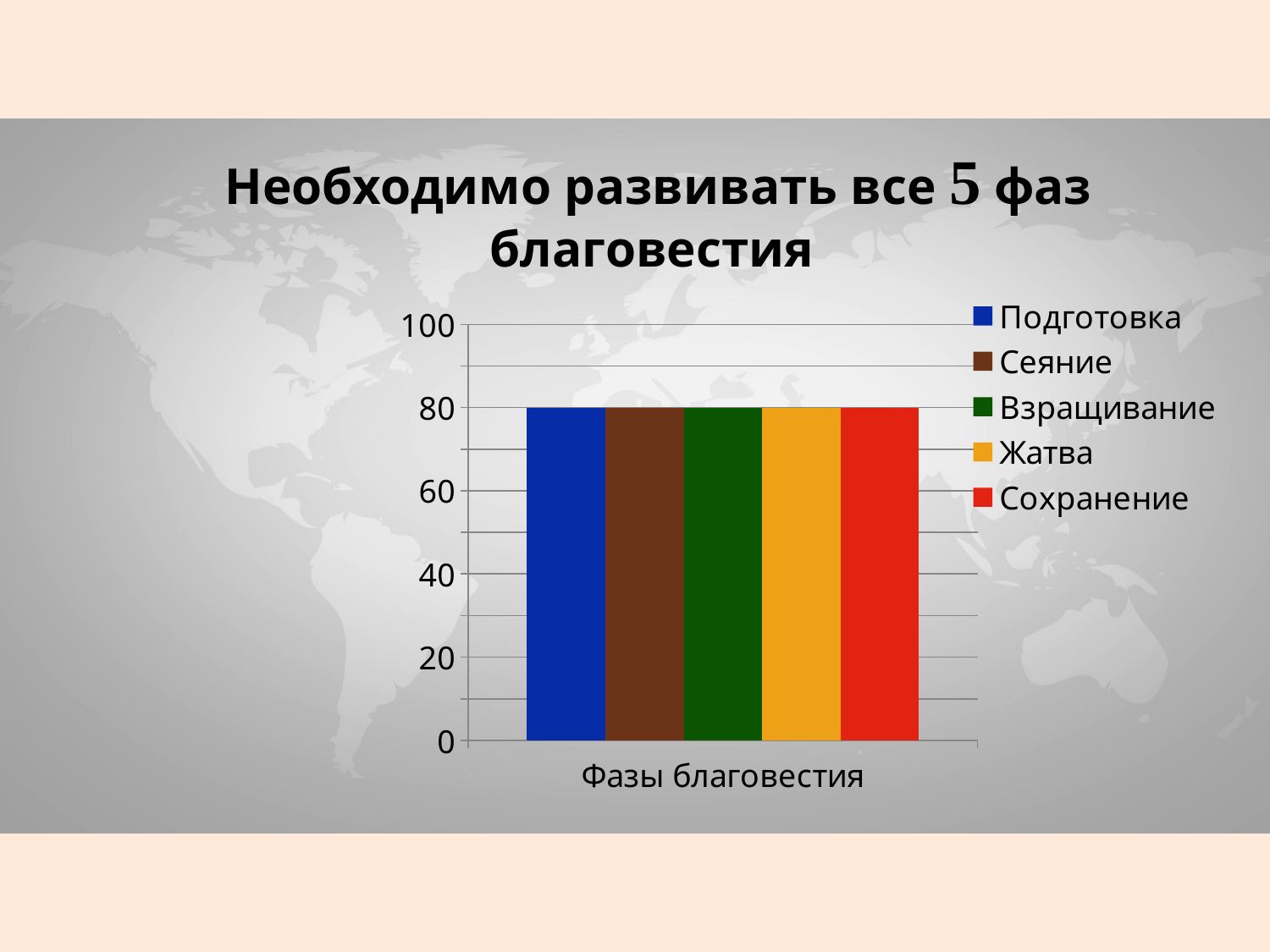
Which colour represents Взращивание in the legend? green What is the value for Подготовка? 80 What is the value for Сеяние? 80 How many series does the legend list? 5 What type of chart is shown on the slide? bar chart What is the value for Взращивание? 80 What is the difference between the values for Подготовка and Сеяние? 0 What is the value for Сохранение? 80 Is the value for Сохранение greater or less than 100? less Is the value for Жатва greater or less than 60? greater What is the label of the category on the x axis? Фазы благовестия What is the value for Жатва? 80